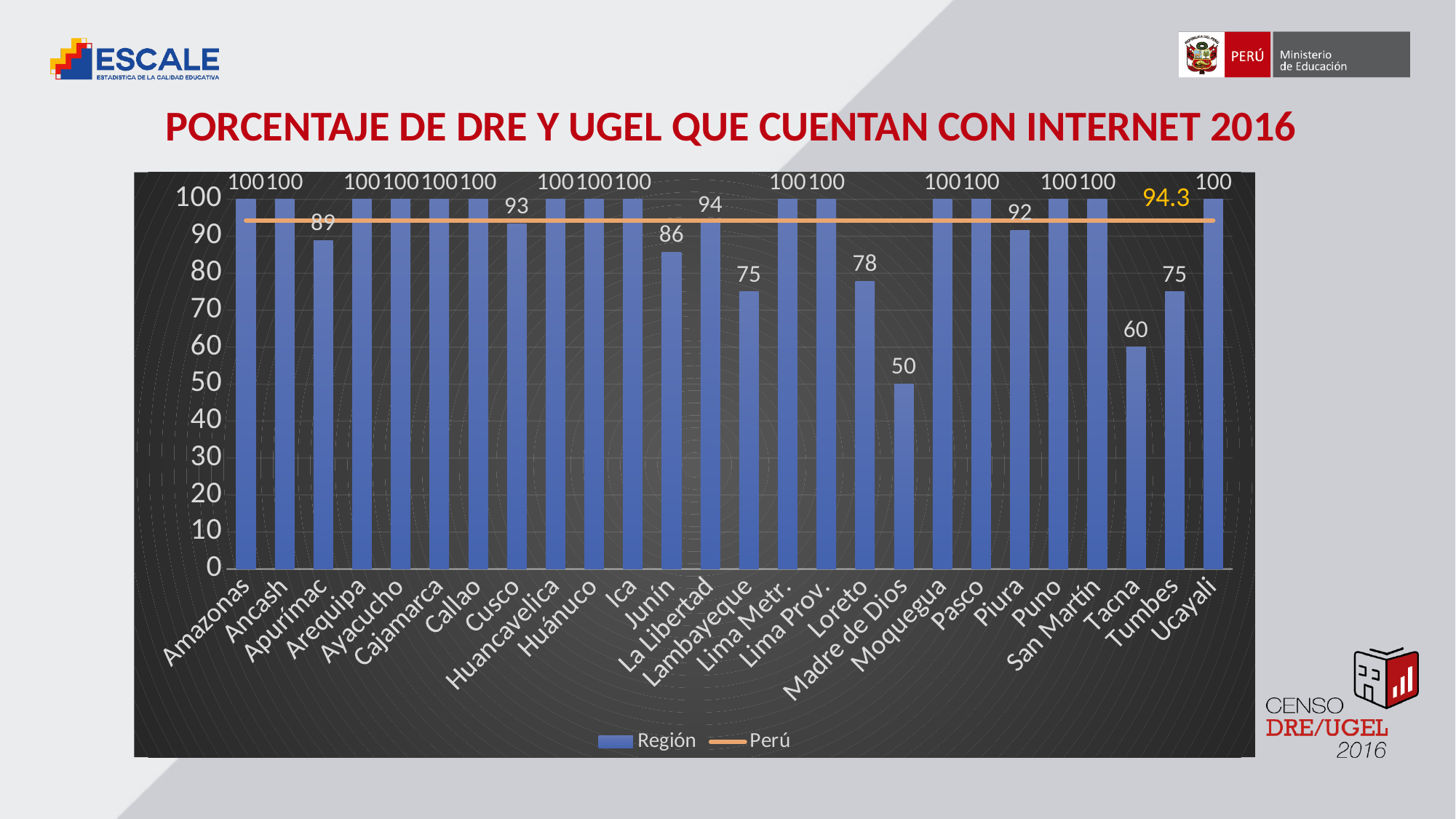
What value does the Perú line show? 94.3 What is the value for Apurímac? 89 Which region has the lowest value? Madre de Dios What is the value for Tacna? 60 What kind of chart is shown on the slide? Combination bar and line chart What is the title of the chart? PORCENTAJE DE DRE Y UGEL QUE CUENTAN CON INTERNET 2016 Which is larger, the value for Piura or the value for La Libertad? La Libertad How many regions are shown on the x axis? 26 What is the difference between the values for Cusco and Junín? 7 How many series does the legend list? 2 What is the difference between the values for Loreto and Lambayeque? 3 What is the value for Madre de Dios? 50